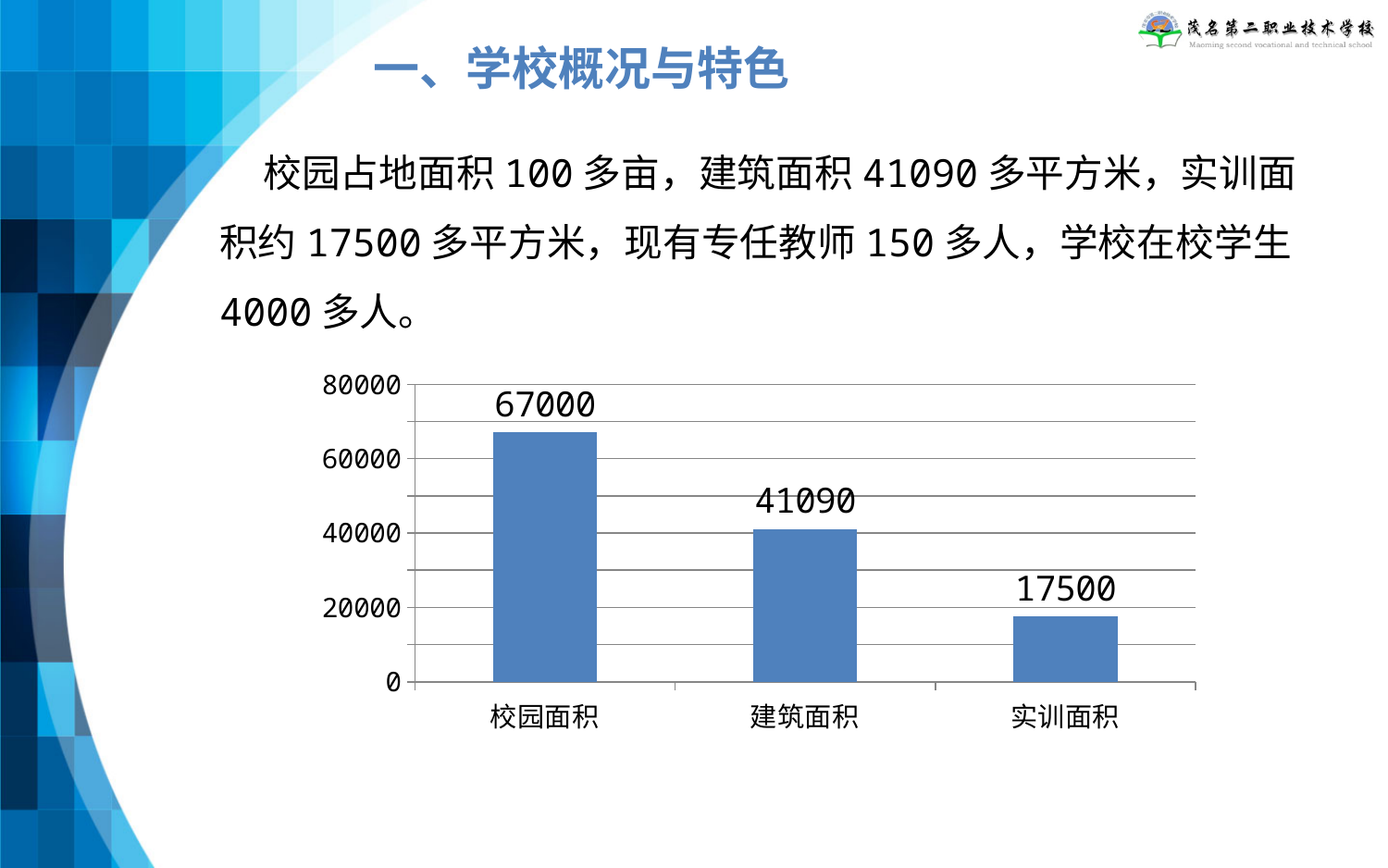
What is the value for 建筑面积? 41090 What is the difference between the values for 校园面积 and 建筑面积? 25910 What kind of chart is shown on the slide? bar chart Which category has the highest value? 校园面积 Which is larger, the value for 建筑面积 or the value for 实训面积? 建筑面积 Is the value for 建筑面积 greater or less than 40000? greater How many categories are shown in the chart? 3 What is the difference between the values for 建筑面积 and 实训面积? 23590 Which category has the lowest value? 实训面积 Do the values rise or fall from left to right along the x axis? fall What is the value for 校园面积? 67000 What is the value for 实训面积? 17500